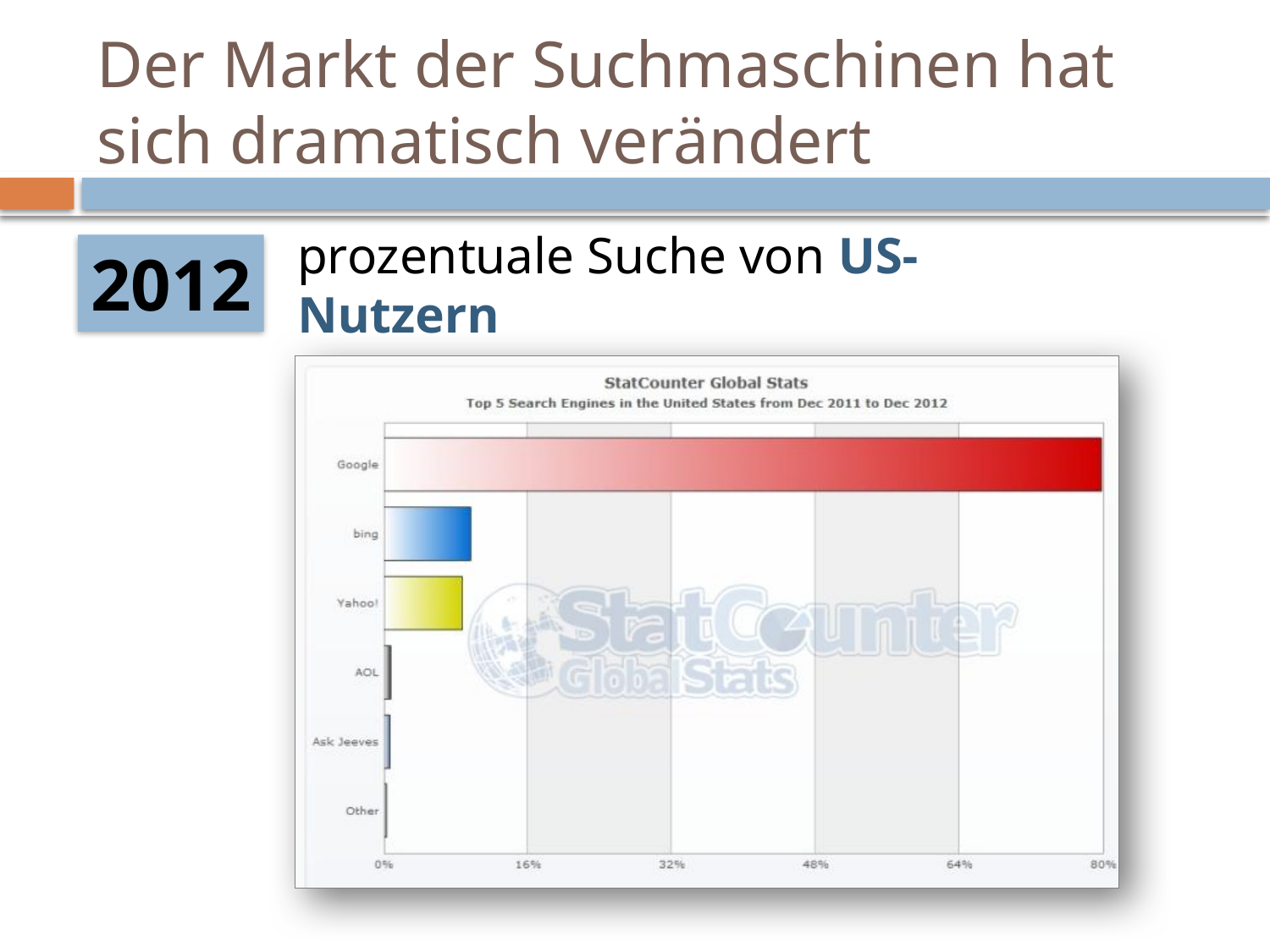
Is the value for bing greater or less than 16%? less Which search engine has the highest share in the chart? Google What is the subtitle of the chart describing the data? Top 5 Search Engines in the United States from Dec 2011 to Dec 2012 What kind of chart is shown on the slide? bar chart How many search engine categories are listed on the chart? 6 What is the highest percentage label shown on the x axis? 80% Is the value for Google greater or less than 48%? greater Is the value for Google greater or less than 64%? greater Which has a larger share, Yahoo! or AOL? Yahoo! Which has a larger share, Google or bing? Google